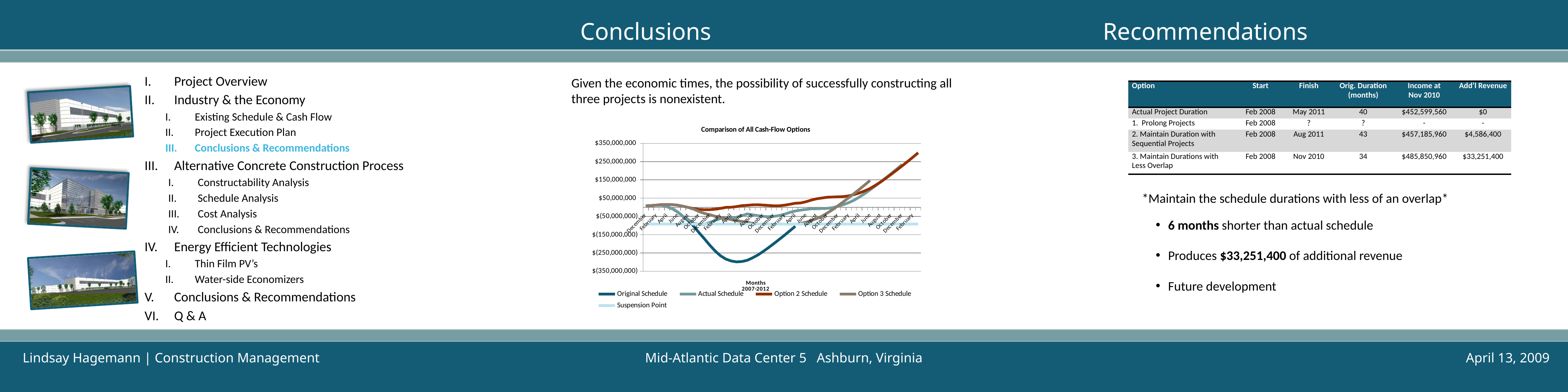
What is the highest value shown on the chart's y axis? $350,000,000 Which series reaches the lowest value on the chart? Original Schedule Is the final value of the Option 2 Schedule line greater or less than $250,000,000? greater Is the lowest point of the Original Schedule line greater or less than $(250,000,000)? less What type of chart is shown on the slide? line chart Which series reaches the highest value on the chart? Option 2 Schedule Over the final months on the x axis, does the Option 2 Schedule line rise or fall? rise Is the Suspension Point line greater or less than $(150,000,000)? greater What is the title of the chart? Comparison of All Cash-Flow Options What is the x-axis title of the chart? Months 2007-2012 How many series does the chart's legend list? 5 At the end of the x axis, which is larger: Option 2 Schedule or Original Schedule? Option 2 Schedule